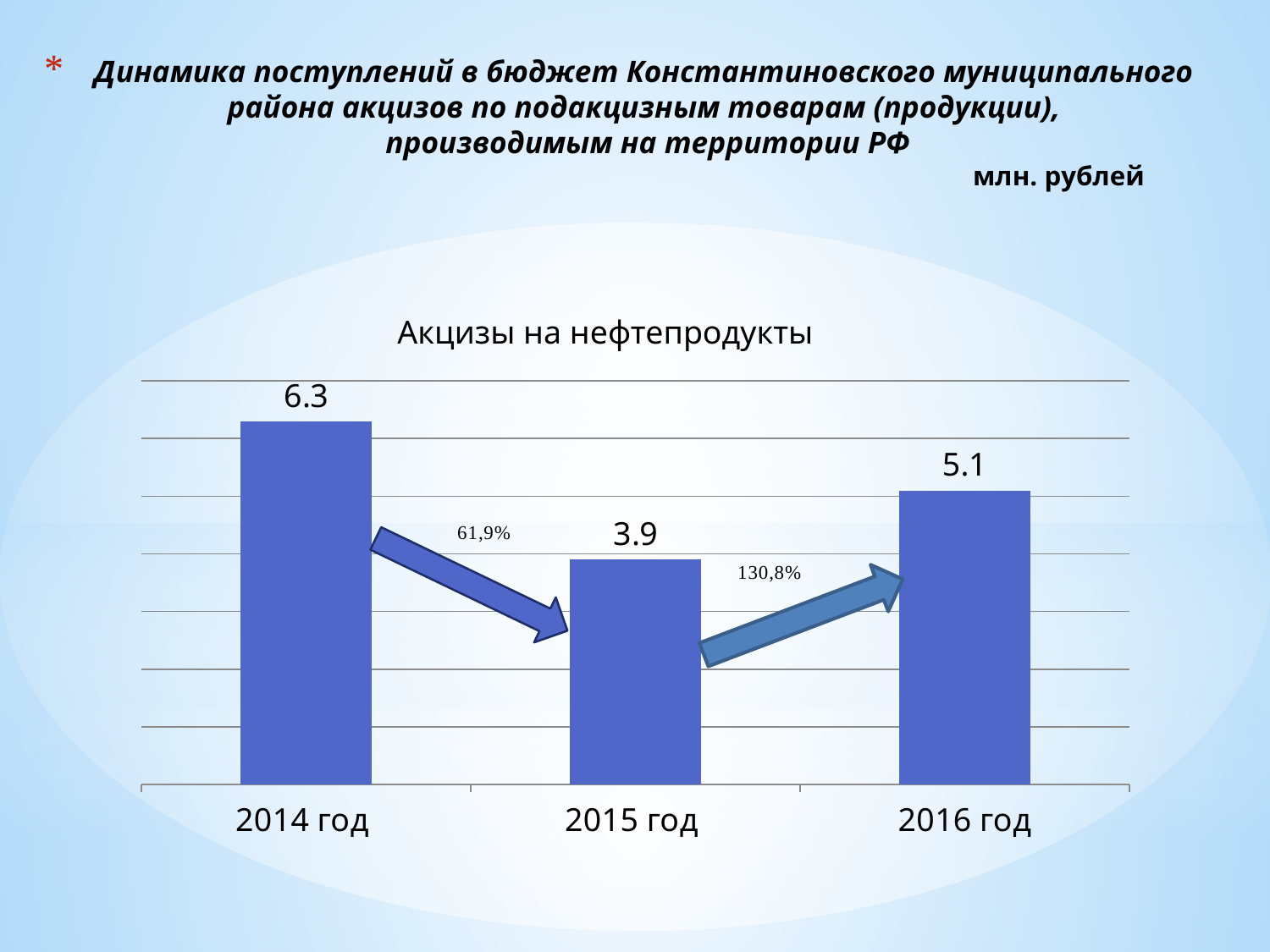
What is the difference between the values for 2014 год and 2015 год? 2.4 What is the value for 2015 год? 3.9 How many years are shown on the chart? 3 What is the value for 2014 год? 6.3 What is the title of the chart? Акцизы на нефтепродукты What kind of chart is this? bar chart What is the value for 2016 год? 5.1 Which year has the highest value? 2014 год What is the difference between the values for 2016 год and 2015 год? 1.2 Which is larger, the value for 2014 год or the value for 2016 год? 2014 год Which year has the lowest value? 2015 год Does the value rise or fall from 2015 год to 2016 год? rise